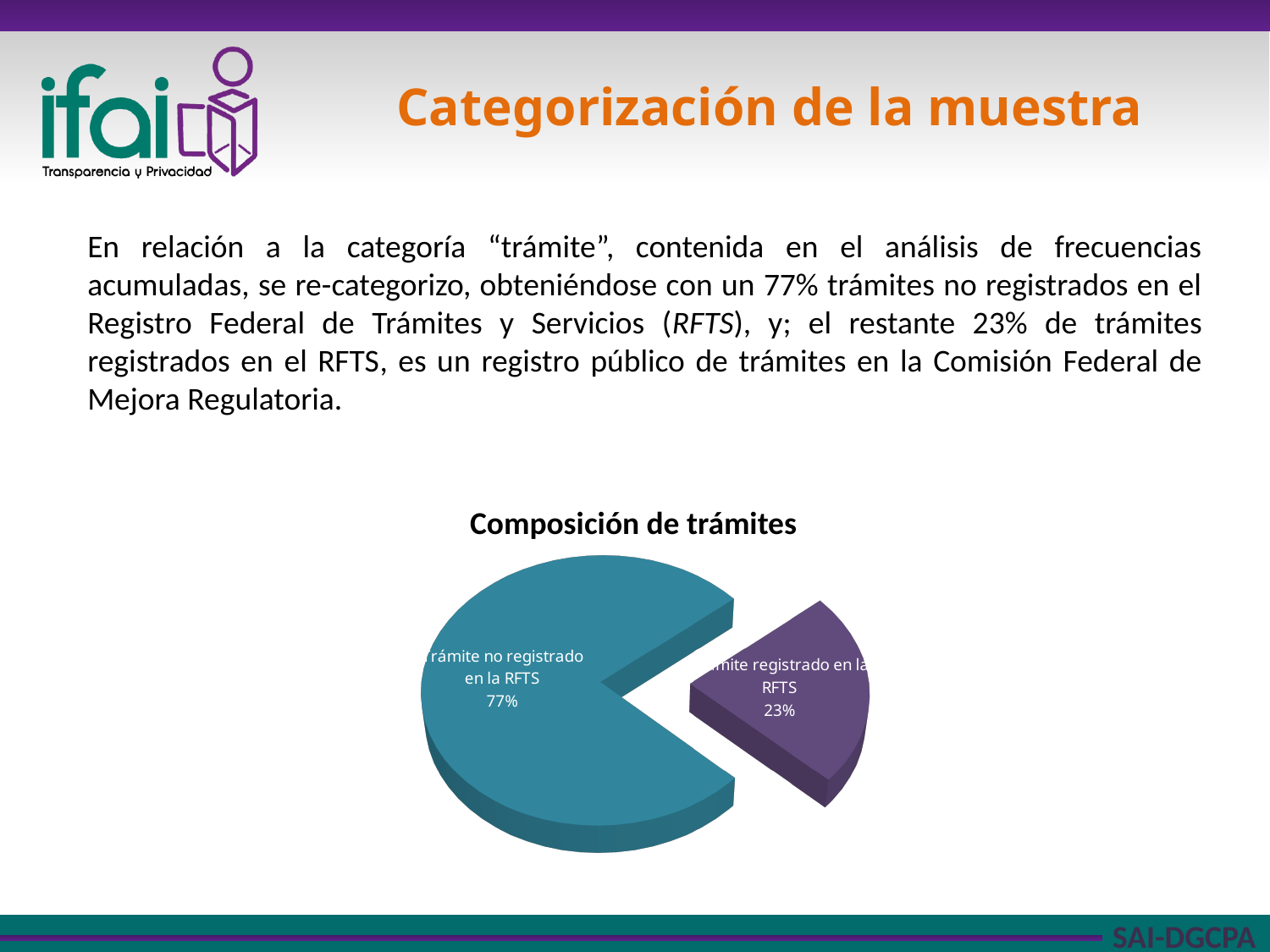
Which slice of the pie is the smallest? Trámite registrado en la RFTS What is the difference in percentage points between the 'Trámite no registrado en la RFTS' slice and the 'Trámite registrado en la RFTS' slice? 54 What kind of chart is shown on the slide? pie chart What is the total of the two slice percentages shown on the pie chart? 100% What is the title of the chart? Composición de trámites What colour is the 'Trámite registrado en la RFTS' slice? purple Which is larger: the share for 'Trámite registrado en la RFTS' or the share for 'Trámite no registrado en la RFTS'? Trámite no registrado en la RFTS What share of the pie is 'Trámite no registrado en la RFTS'? 77% What share of the pie is 'Trámite registrado en la RFTS'? 23% Which slice of the pie is the largest? Trámite no registrado en la RFTS How many slices does the pie chart have? 2